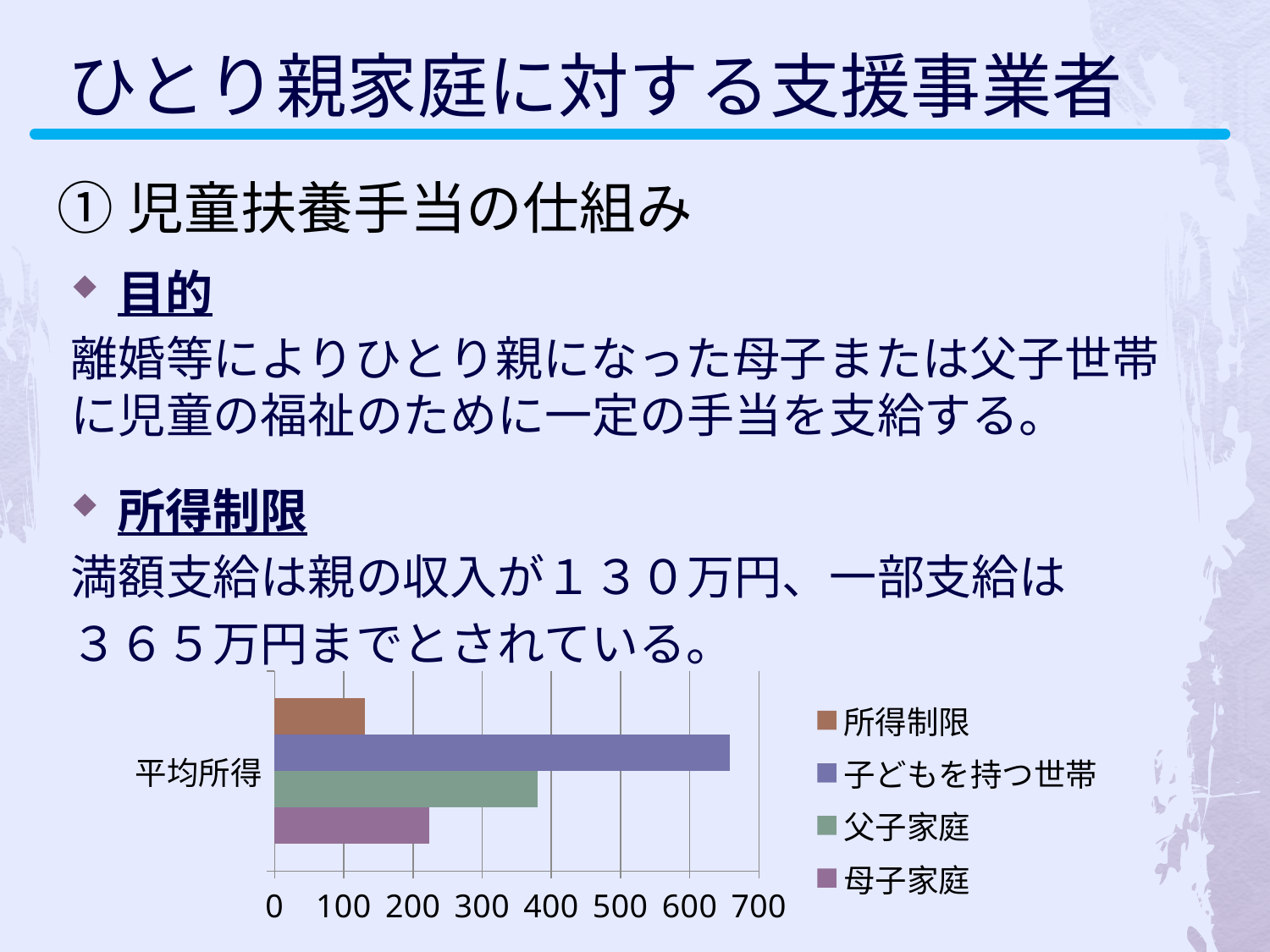
Which is larger, the value for 父子家庭 or the value for 母子家庭? 父子家庭 What is the category label shown on the chart's vertical axis? 平均所得 Is the value for 所得制限 greater or less than 200? less Which series is shown in green in the chart legend? 父子家庭 What kind of chart is shown on the slide? bar chart Is the value for 子どもを持つ世帯 greater or less than 600? greater Is the value for 父子家庭 greater or less than 300? greater Which series has the highest value in the chart? 子どもを持つ世帯 Which series has the lowest value in the chart? 所得制限 How many series does the chart legend list? 4 How many categories are shown on the chart's vertical axis? 1